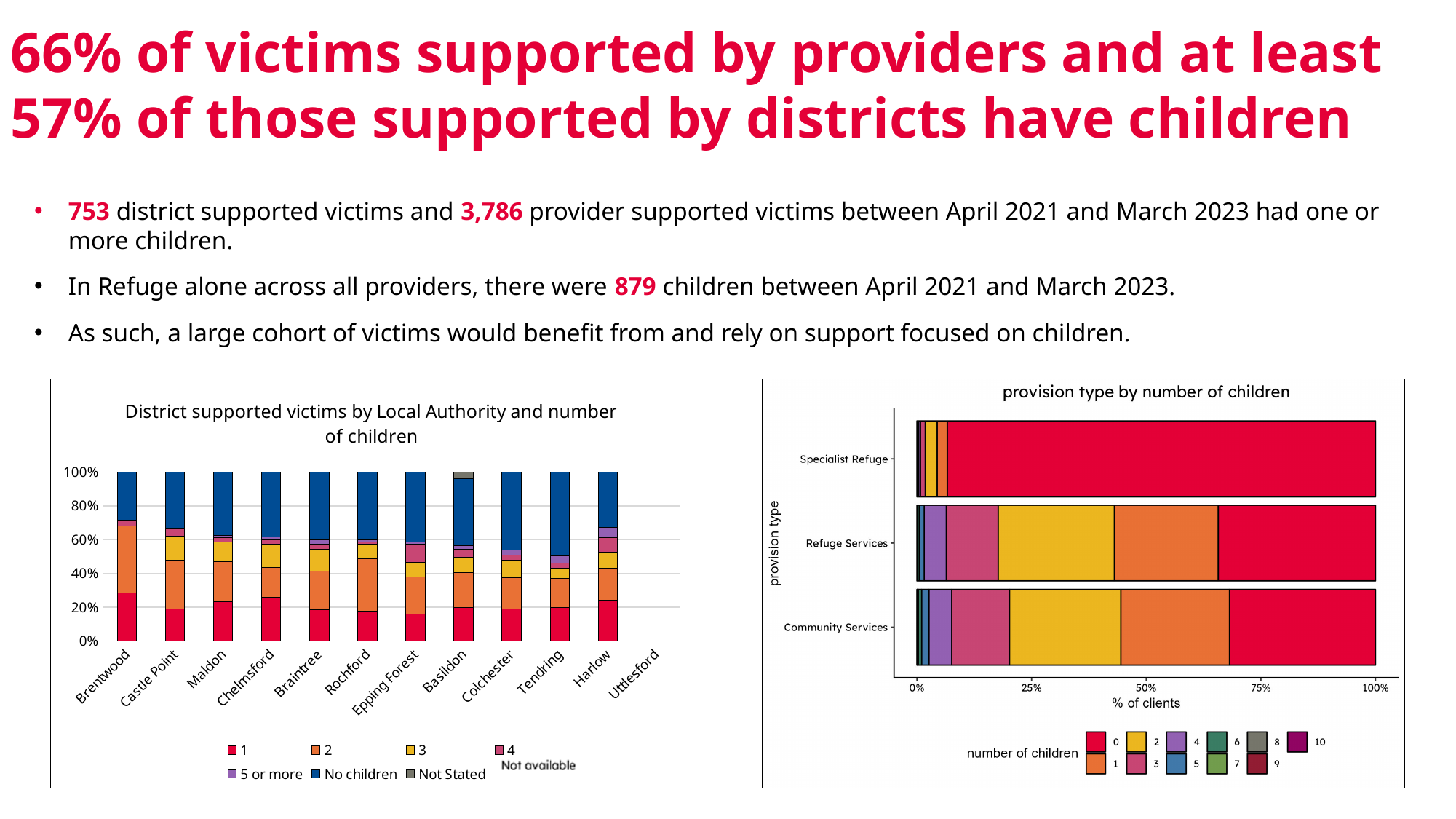
In the right chart, which provision type has the largest share of clients with 0 children? Specialist Refuge What is the title of the right chart? provision type by number of children In the left chart, is the share of victims with 1 child in Epping Forest greater or less than 20%? less In the left chart, which local authority has no bar plotted and is marked 'Not available'? Uttlesford In the left chart, how many series does the legend list? 7 In the right chart, is the share of Specialist Refuge clients with 0 children greater or less than 75%? greater In the left chart, which has the larger share of victims with 1 child, Brentwood or Epping Forest? Brentwood What type of chart is the left chart, 'District supported victims by Local Authority and number of children'? Stacked bar chart In the right chart, how many entries does the 'number of children' legend list? 11 In the left chart, how many local authorities are listed on the x axis? 12 In the left chart, is the share of victims with 1 child in Brentwood greater or less than 20%? greater In the right chart, how many provision types are shown on the y axis? 3